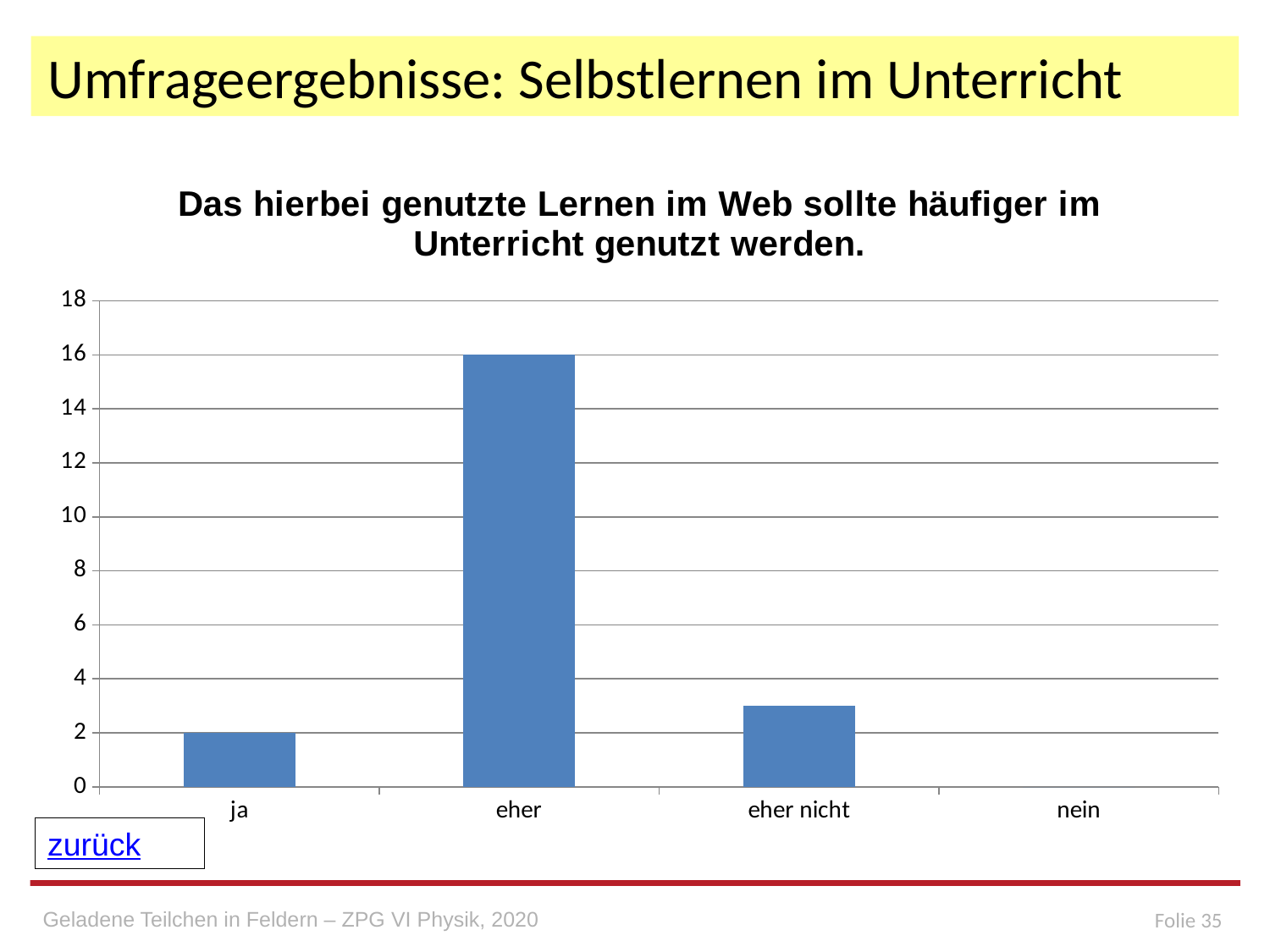
What is the difference between the value for "eher" and the value for "ja"? 14 What is the value for "nein"? 0 Is the value for "eher nicht" greater or less than 2? greater Which category has the highest value in the chart? eher What is the value for "eher"? 16 What is the value for "ja"? 2 Which category has the lowest value in the chart? nein What is the title of the chart? Das hierbei genutzte Lernen im Web sollte häufiger im Unterricht genutzt werden. Which is larger, the value for "ja" or the value for "eher nicht"? eher nicht What kind of chart is shown on the slide? bar chart Is the value for "eher nicht" greater or less than 4? less How many categories are shown on the x axis of the chart? 4